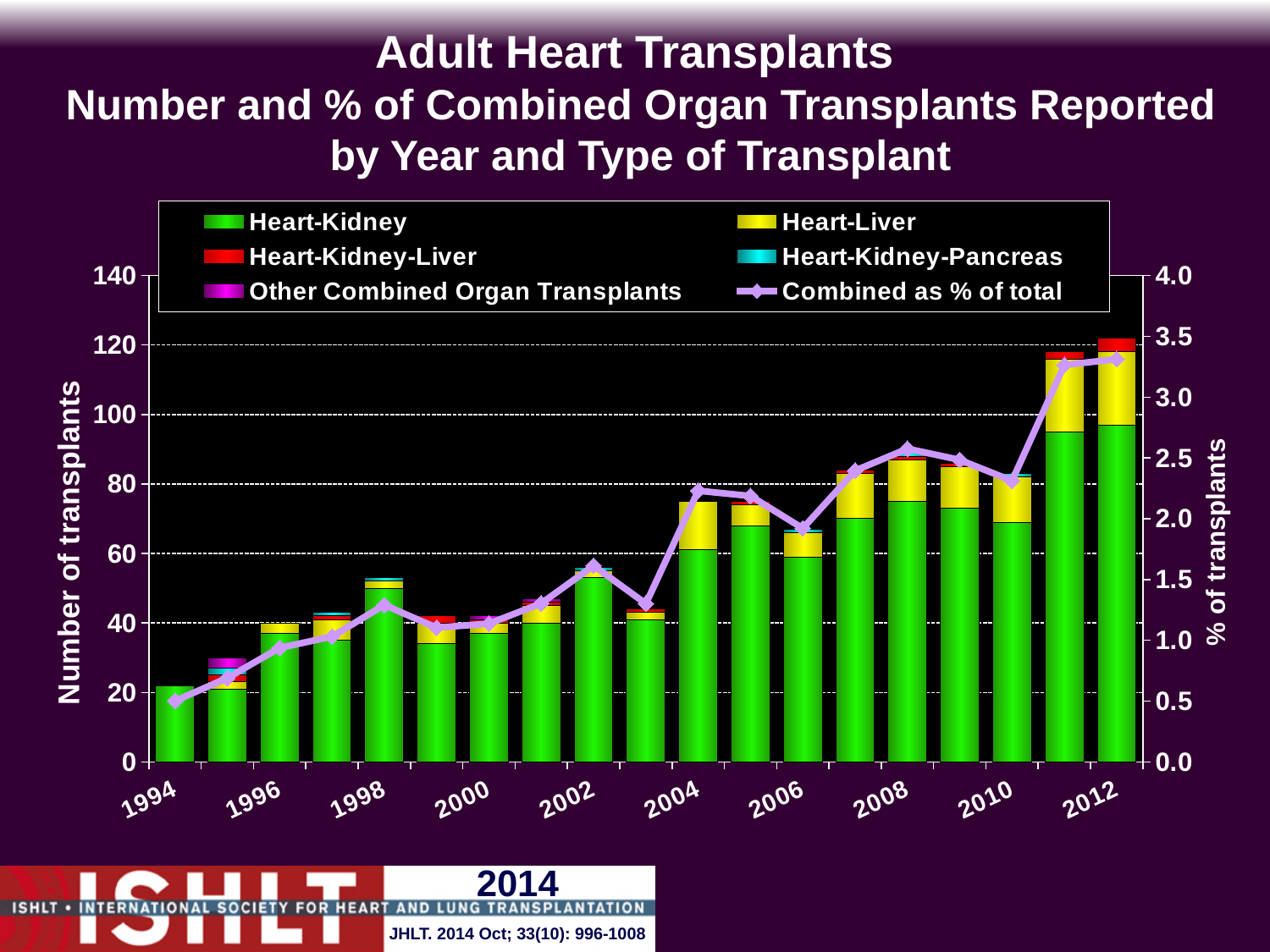
Is the total number of transplants for 2008 greater or less than 80? greater What kind of chart is shown on the slide? Stacked bar chart with a line overlay Which year has the lowest total number of combined organ transplants? 1994 Is the total number of transplants for 1994 greater or less than 40? less Overall, does the number of combined organ transplants rise or fall from 1994 to 2012? rise How many years (bars) are plotted along the x axis? 19 How many series does the legend list? 6 Which legend entry is plotted as a line rather than bars? Combined as % of total What is the label of the right-hand vertical axis? % of transplants Which year has the larger total number of transplants, 2003 or 2004? 2004 Is the total number of transplants for 2006 greater or less than 80? less